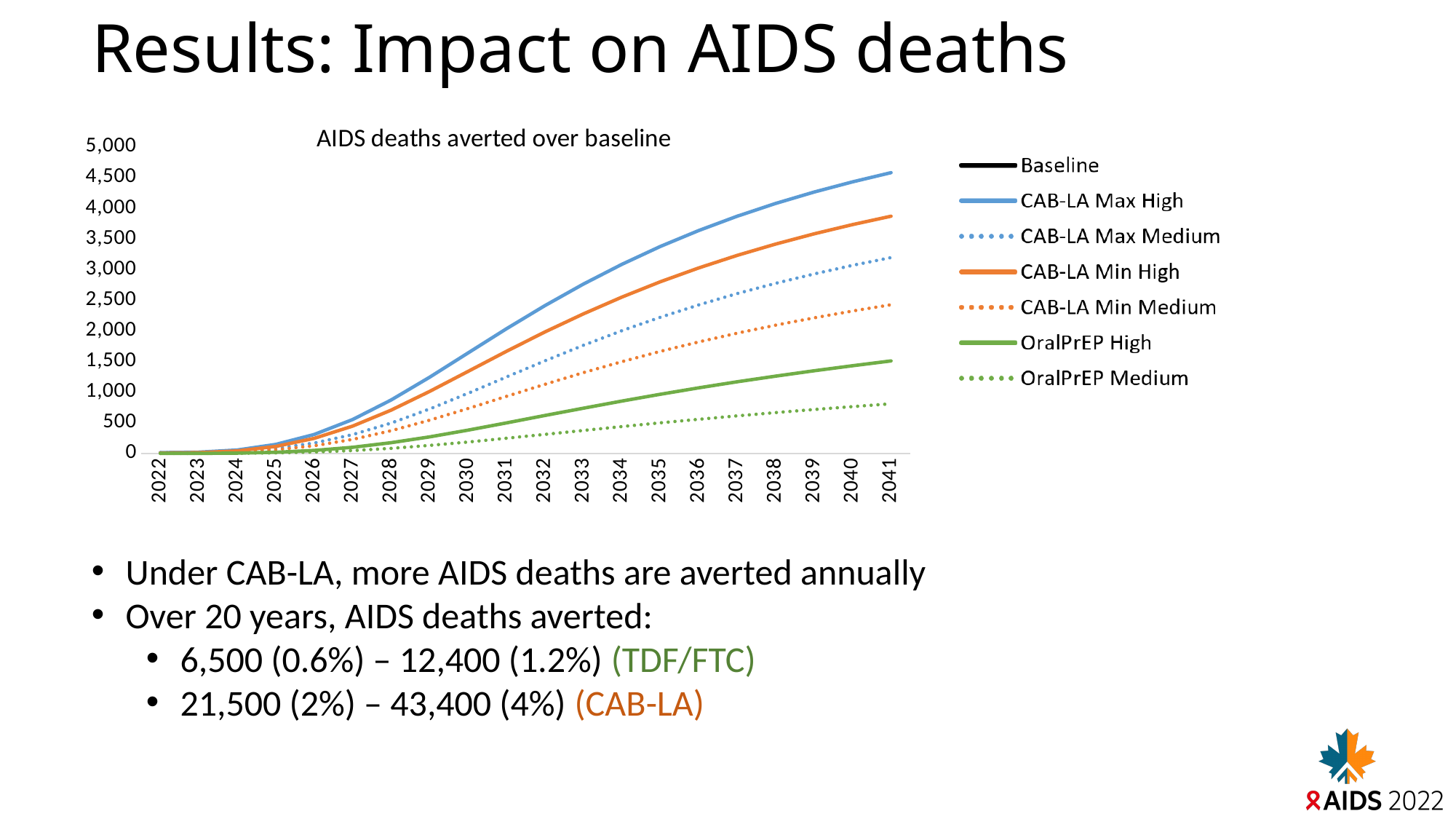
How many years are shown along the x axis of the chart? 20 How many series does the chart legend list? 7 Is the value for OralPrEP High in 2041 greater or less than 1,000? greater Is the value for OralPrEP Medium in 2041 greater or less than 1,000? less Is the value for CAB-LA Max High in 2041 greater or less than 4,000? greater Apart from Baseline, which series has the lowest value in 2041? OralPrEP Medium What kind of chart is shown on the slide? Line chart What is the title of the chart? AIDS deaths averted over baseline In 2041, which is larger: CAB-LA Min High or CAB-LA Max Medium? CAB-LA Min High Which series reaches the highest value in 2041? CAB-LA Max High Do the values for CAB-LA Max High rise or fall from 2022 to 2041? Rise